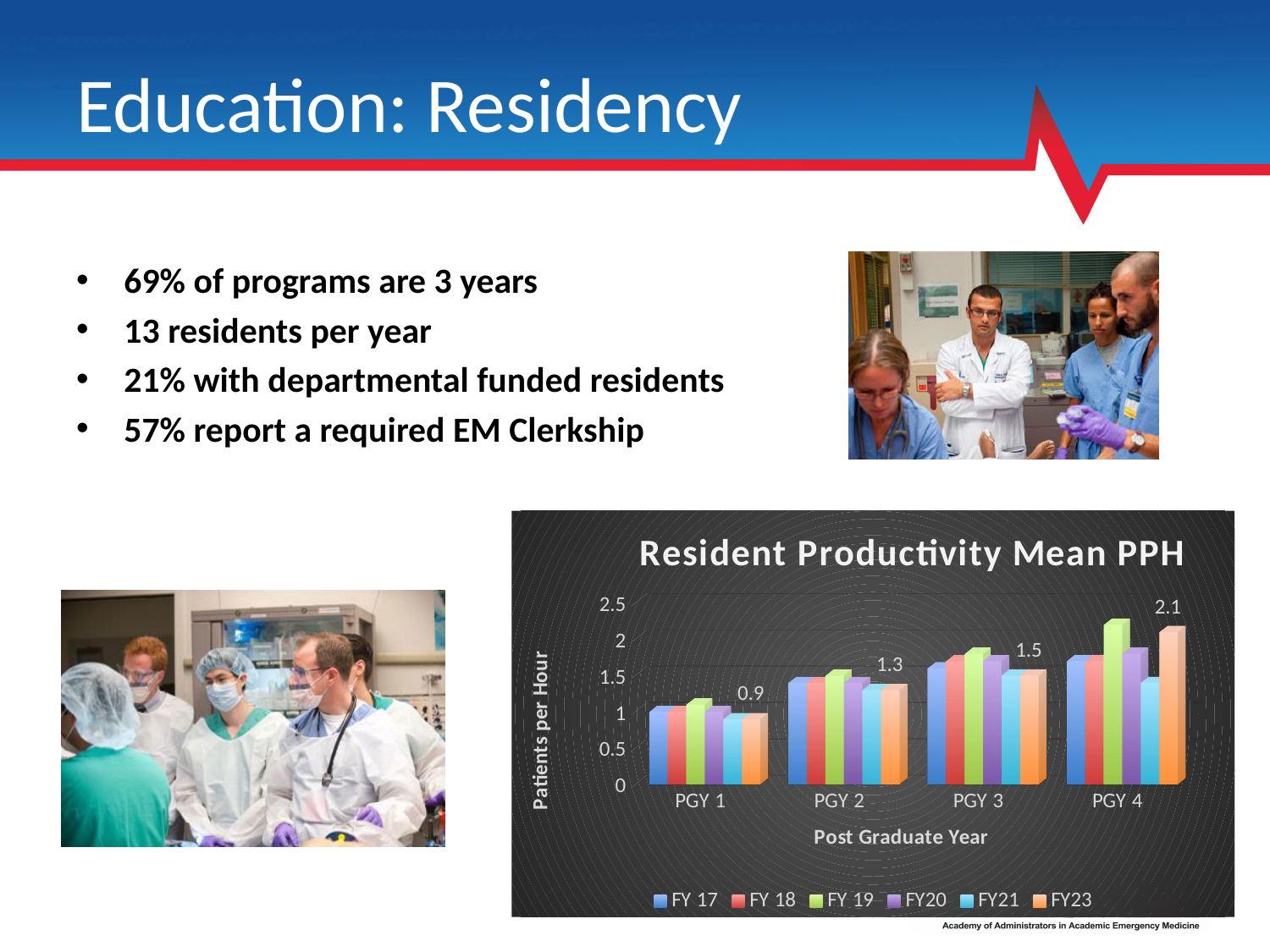
What is the difference between the labelled values for PGY 4 and PGY 1? 1.2 What data label is shown for PGY 1? 0.9 How many post graduate year categories are shown on the x axis? 4 Do the labelled values rise or fall from PGY 1 to PGY 4? rise What is the title of the chart? Resident Productivity Mean PPH How many series does the chart legend list? 6 What type of chart is shown on the slide? bar chart What data label is shown for PGY 2? 1.3 Which post graduate year has the highest labelled value? PGY 4 What data label is shown for PGY 3? 1.5 Is the value for FY 19 at PGY 4 greater or less than 2? greater What data label is shown for PGY 4? 2.1